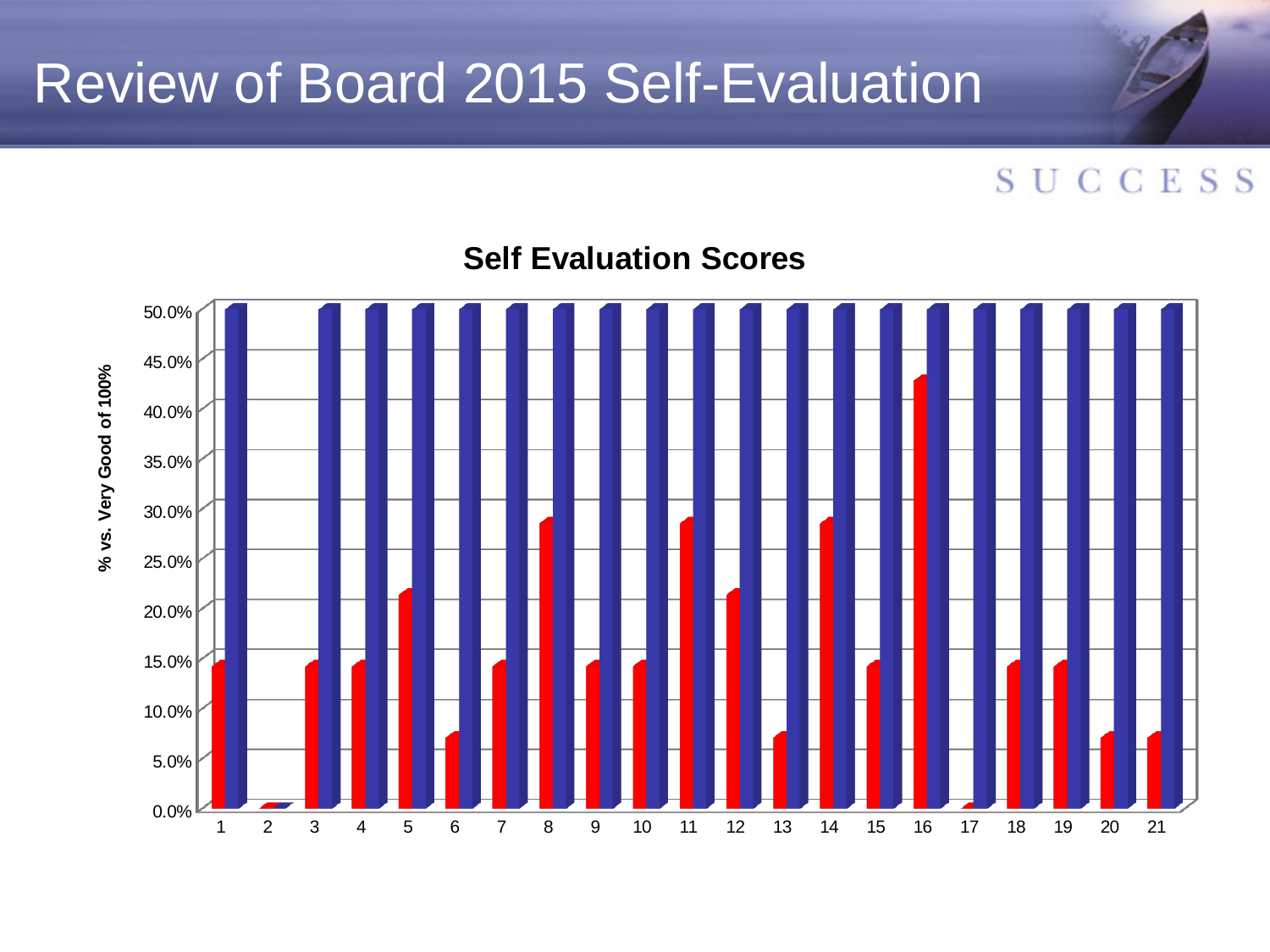
Which has the larger red bar, category 8 or category 6? category 8 Is the red bar for category 16 greater or less than 40.0%? greater What kind of chart is shown on the slide? bar chart Which category has the tallest red bar in the Self Evaluation Scores chart? 16 What is the title of the chart? Self Evaluation Scores Is the red bar for category 16 greater or less than 45.0%? less Is the red bar for category 6 greater or less than 10.0%? less What value does the blue bar for category 1 reach on the y axis? 50.0% What is the label on the vertical axis of the chart? % vs. Very Good of 100% How many categories are shown along the x axis of the Self Evaluation Scores chart? 21 Which has the larger red bar, category 12 or category 13? category 12